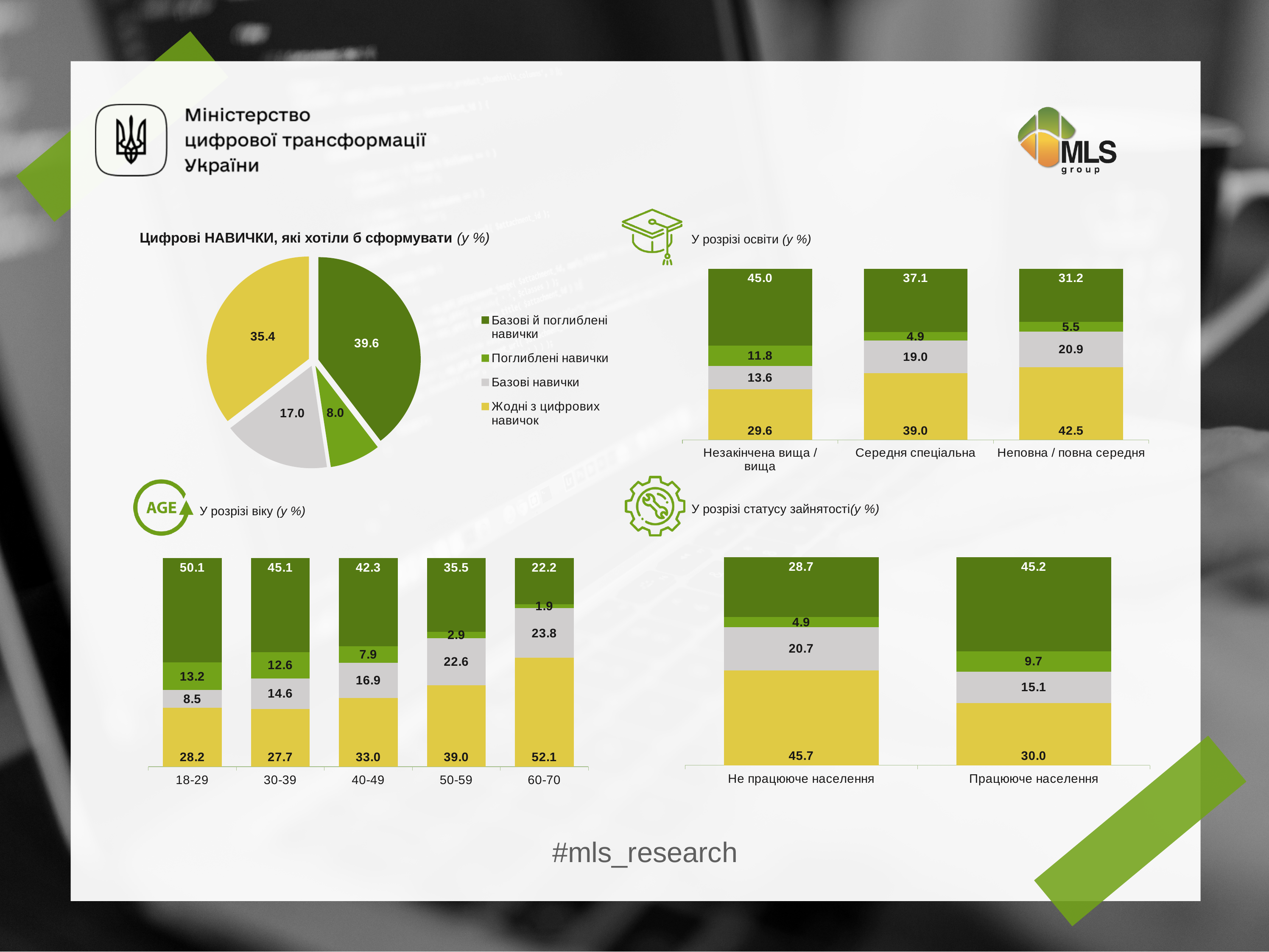
In the chart 'У розрізі статусу зайнятості', which group has the larger yellow (Жодні з цифрових навичок) value: 'Не працююче населення' or 'Працююче населення'? Не працююче населення In the chart 'У розрізі освіти', which education category has the highest value for the dark green (Базові й поглиблені навички) segment? Незакінчена вища / вища In the chart 'У розрізі статусу зайнятості', what is the value of the light green (Поглиблені навички) segment for 'Працююче населення'? 9.7 How many entries does the legend of the pie chart 'Цифрові НАВИЧКИ, які хотіли б сформувати' list? 4 In the chart 'У розрізі віку', what is the total of the stacked bar for the 18-29 age group? 100.0 In the chart 'У розрізі освіти', what is the difference between the yellow segment values for 'Неповна / повна середня' and 'Незакінчена вища / вища'? 12.9 In the chart 'У розрізі віку', how many age groups are shown? 5 In the chart 'У розрізі освіти', what is the value of the yellow (Жодні з цифрових навичок) segment for 'Середня спеціальна'? 39.0 In the chart 'У розрізі віку', how does the dark green (Базові й поглиблені навички) value change from the 18-29 group to the 60-70 group? It falls What type of chart is the top-left chart 'Цифрові НАВИЧКИ, які хотіли б сформувати'? Pie chart In the pie chart 'Цифрові НАВИЧКИ, які хотіли б сформувати', which category has the smallest slice? Поглиблені навички In the pie chart 'Цифрові НАВИЧКИ, які хотіли б сформувати', what is the value for 'Базові й поглиблені навички'? 39.6